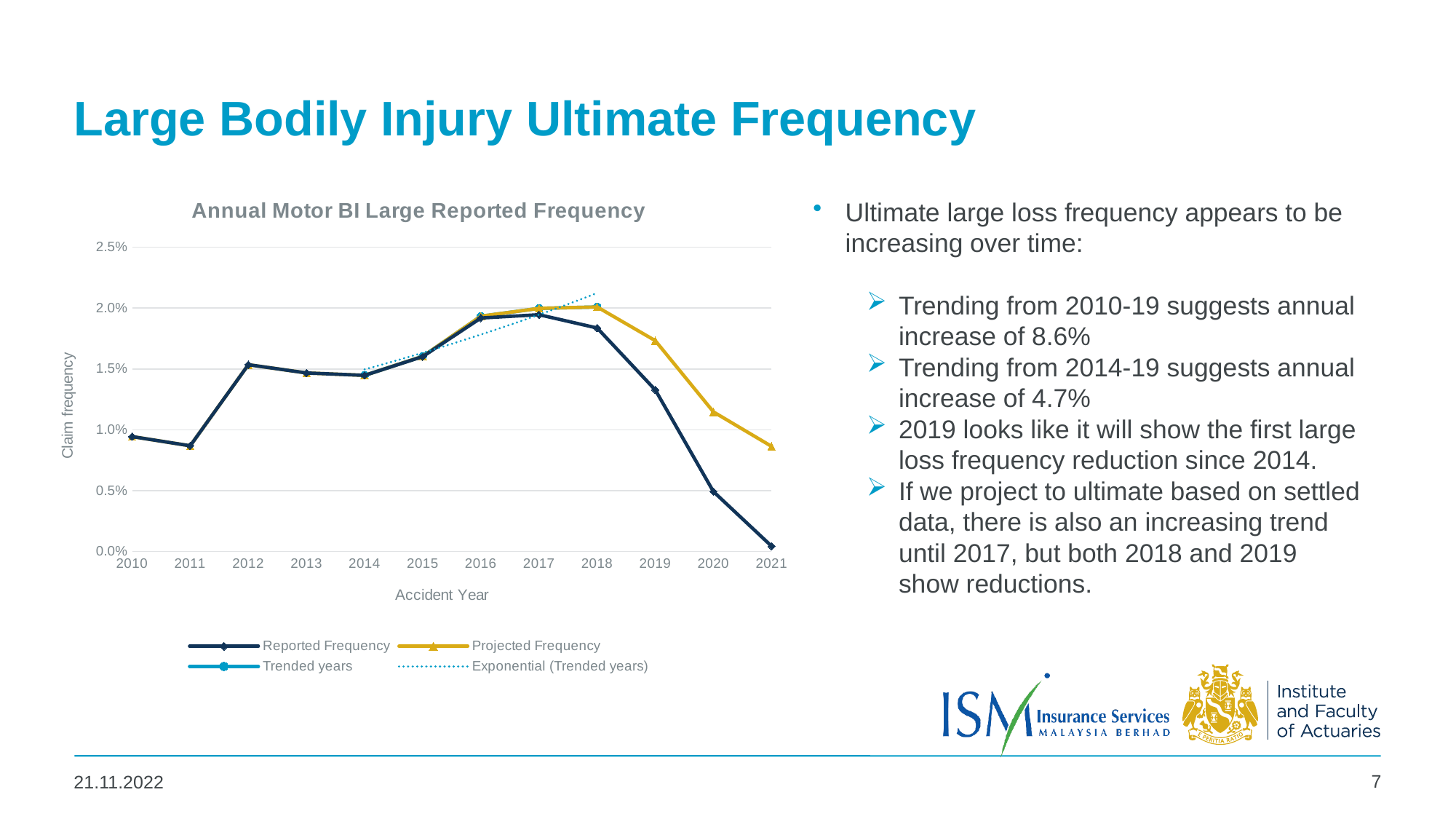
How many accident years are shown on the x axis of the chart? 12 Is the Projected Frequency value for 2020 greater or less than 1.0%? greater Is the Reported Frequency value for 2019 greater or less than 1.5%? less What is the title of the chart? Annual Motor BI Large Reported Frequency For 2019, which is larger: the Reported Frequency or the Projected Frequency? Projected Frequency Does the Reported Frequency rise or fall from 2018 to 2021? fall Is the Reported Frequency value for 2011 greater or less than 1.0%? less What is the label of the chart's vertical axis? Claim frequency In which accident year is the Reported Frequency lowest? 2021 What kind of chart is shown on the slide? line chart How many series does the chart legend list? 4